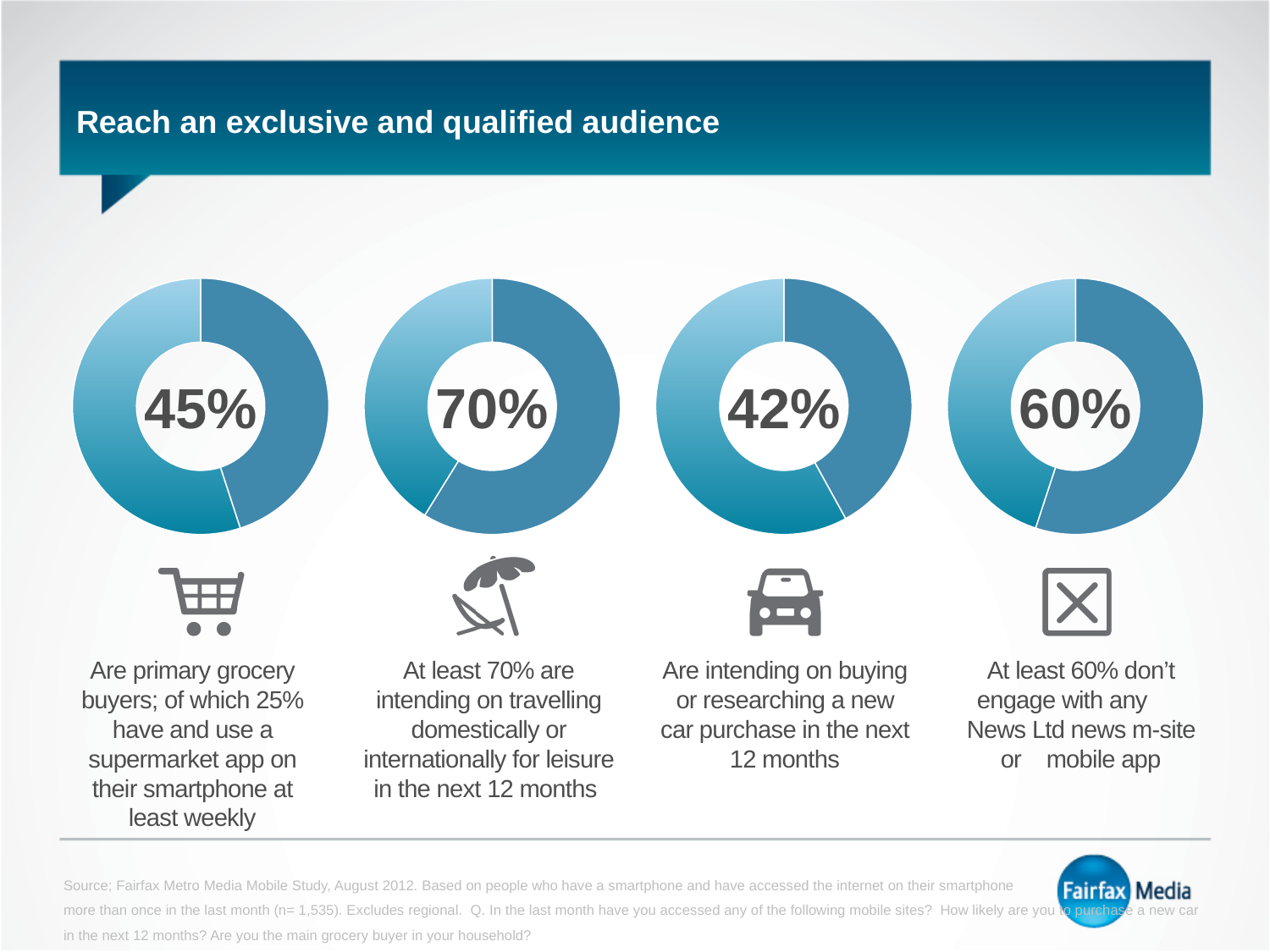
What type of chart is used to display the percentages on this slide? Donut (pie) chart Which of the four donut charts shows the lowest percentage? The third chart (new car purchase), 42% What percentage is shown in the second donut chart, for those intending to travel for leisure in the next 12 months? 70% What percentage is shown in the leftmost donut chart, for primary grocery buyers? 45% Which of the four donut charts shows the highest percentage? The second chart (travelling for leisure), 70% What percentage is shown in the rightmost donut chart, for those who don't engage with any News Ltd news m-site or mobile app? 60% What is the difference between the percentage in the rightmost donut chart (60%) and the leftmost donut chart (45%)? 15 percentage points How many donut charts are shown on the slide? 4 What is the difference between the percentage in the second donut chart (70%) and the third donut chart (42%)? 28 percentage points What percentage is shown in the third donut chart, for those intending on buying or researching a new car purchase in the next 12 months? 42% Which is larger: the percentage in the leftmost donut chart (grocery buyers) or the rightmost donut chart (don't engage with News Ltd)? The rightmost chart, 60% What is the title of the slide containing the four donut charts? Reach an exclusive and qualified audience